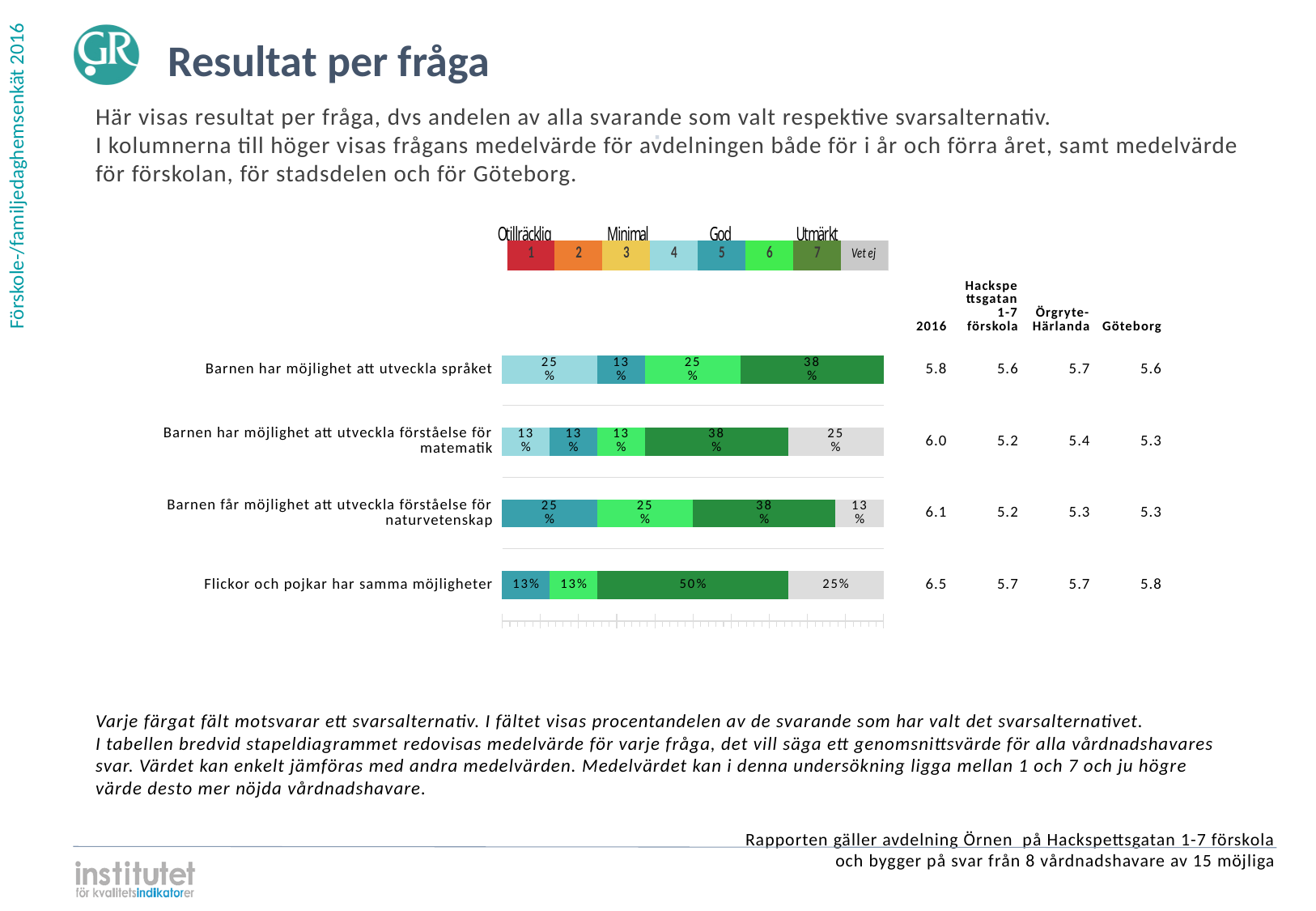
Which question has the lowest 2016 mean value in the table? Barnen har möjlighet att utveckla språket What percentage is shown for the largest segment of the bar 'Flickor och pojkar har samma möjligheter'? 50% What is the difference between the 2016 mean and the Göteborg mean for 'Flickor och pojkar har samma möjligheter'? 0.7 What is the 2016 mean value for 'Flickor och pojkar har samma möjligheter'? 6.5 What percentage is shown for the dark green segment of the bar 'Barnen har möjlighet att utveckla språket'? 38% For 'Barnen har möjlighet att utveckla förståelse för matematik', which is larger: the 2016 mean or the Hackspettsgatan 1-7 förskola mean? 2016 mean How many response options does the legend above the chart list? 8 How many questions (categories) are shown as bars in the chart? 4 What are the four scale labels shown above the legend, from left to right? Otillräcklig, Minimal, God, Utmärkt What kind of chart is used to show the results per question? Stacked bar chart What percentage is shown for the grey 'Vet ej' segment of the bar 'Barnen har möjlighet att utveckla förståelse för matematik'? 25% Which question has the highest 2016 mean value in the table? Flickor och pojkar har samma möjligheter